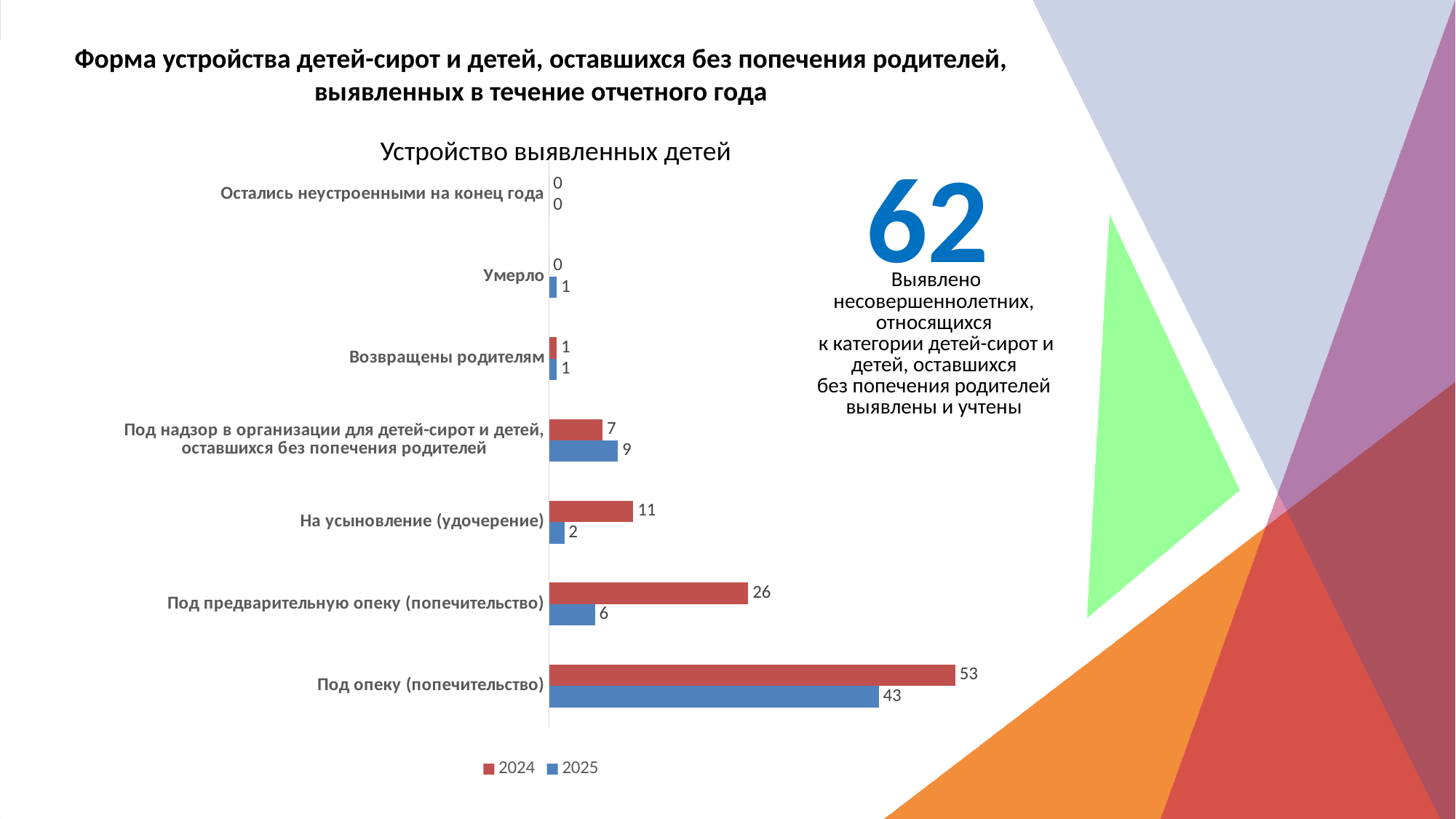
What kind of chart is shown on the slide? Bar chart What is the 2025 value for «Под надзор в организации для детей-сирот и детей, оставшихся без попечения родителей»? 9 What is the title of the chart? Устройство выявленных детей Which category has the highest 2025 value? Под опеку (попечительство) How many categories are shown on the chart? 7 What is the 2024 value for «На усыновление (удочерение)»? 11 What is the 2025 value for «Под предварительную опеку (попечительство)»? 6 What is the 2024 value for «Под опеку (попечительство)»? 53 What is the difference between the 2024 and 2025 values for «Под предварительную опеку (попечительство)»? 20 For «На усыновление (удочерение)», which year has the larger value, 2024 or 2025? 2024 What is the difference between the 2024 and 2025 values for «Под опеку (попечительство)»? 10 How many series does the legend list? 2